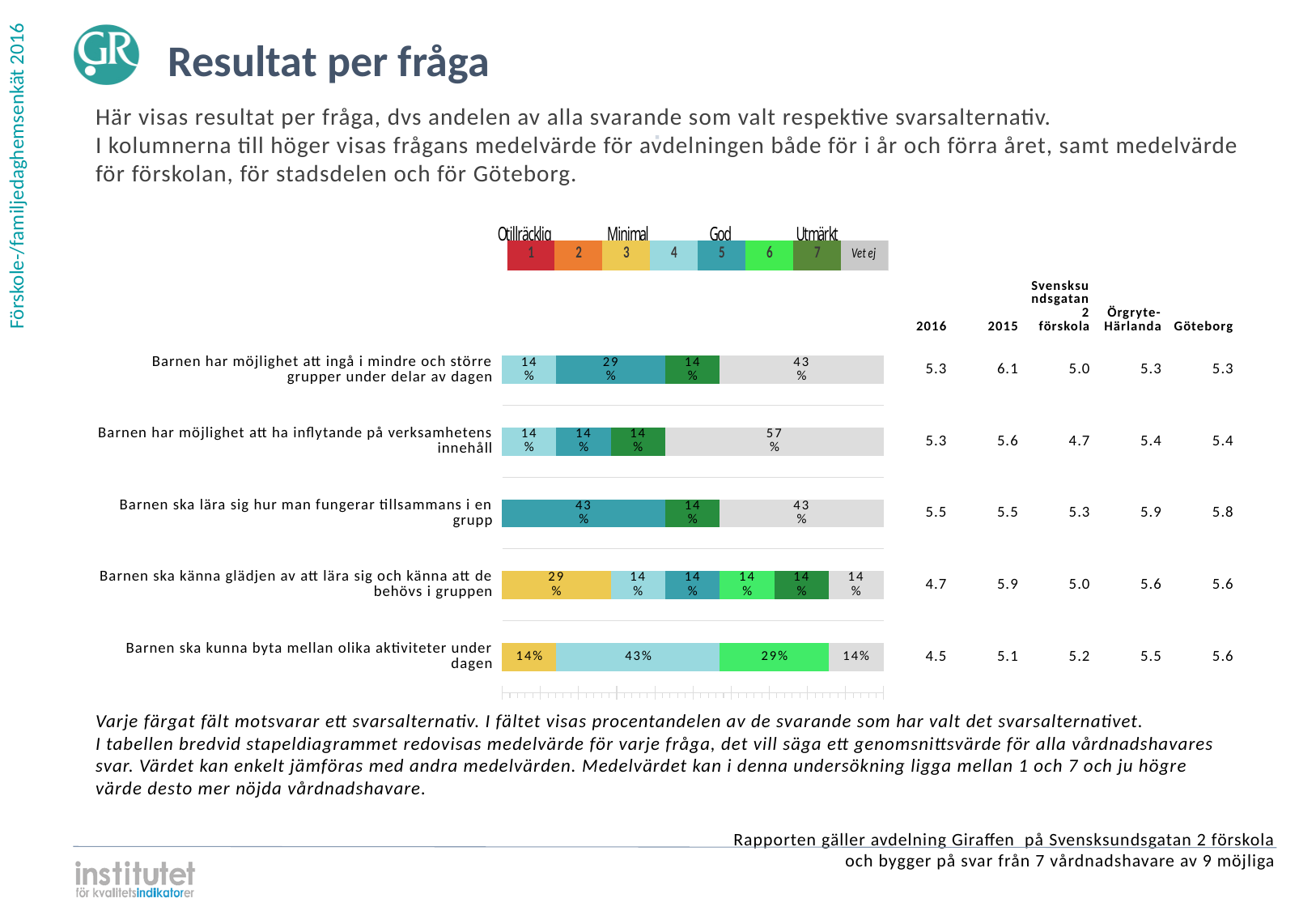
What percentage chose option 3 (yellow) for 'Barnen ska känna glädjen av att lära sig och känna att de behövs i gruppen'? 29% What percentage of respondents answered 'Vet ej' for 'Barnen har möjlighet att ha inflytande på verksamhetens innehåll'? 57% What is the total of the segments in the bar for 'Barnen har möjlighet att ingå i mindre och större grupper under delar av dagen'? 100% What percentage chose option 6 (light green) for 'Barnen ska kunna byta mellan olika aktiviteter under dagen'? 29% What percentage chose option 5 (teal) for 'Barnen ska lära sig hur man fungerar tillsammans i en grupp'? 43% What is the difference in 'Vet ej' share between 'Barnen har möjlighet att ha inflytande på verksamhetens innehåll' and 'Barnen har möjlighet att ingå i mindre och större grupper under delar av dagen'? 14 percentage points How many questions (categories) are plotted in the bar chart? 5 Which question has the largest 'Vet ej' share? Barnen har möjlighet att ha inflytande på verksamhetens innehåll How many response options does the legend above the chart list, including 'Vet ej'? 8 Which is larger: the option 4 (light blue) share for 'Barnen ska kunna byta mellan olika aktiviteter under dagen' or the option 3 (yellow) share for 'Barnen ska känna glädjen av att lära sig och känna att de behövs i gruppen'? Option 4 share for 'Barnen ska kunna byta mellan olika aktiviteter under dagen' (43%) Which colour in the legend represents the 'Vet ej' response? Grey What kind of chart is shown on the slide? Stacked bar chart